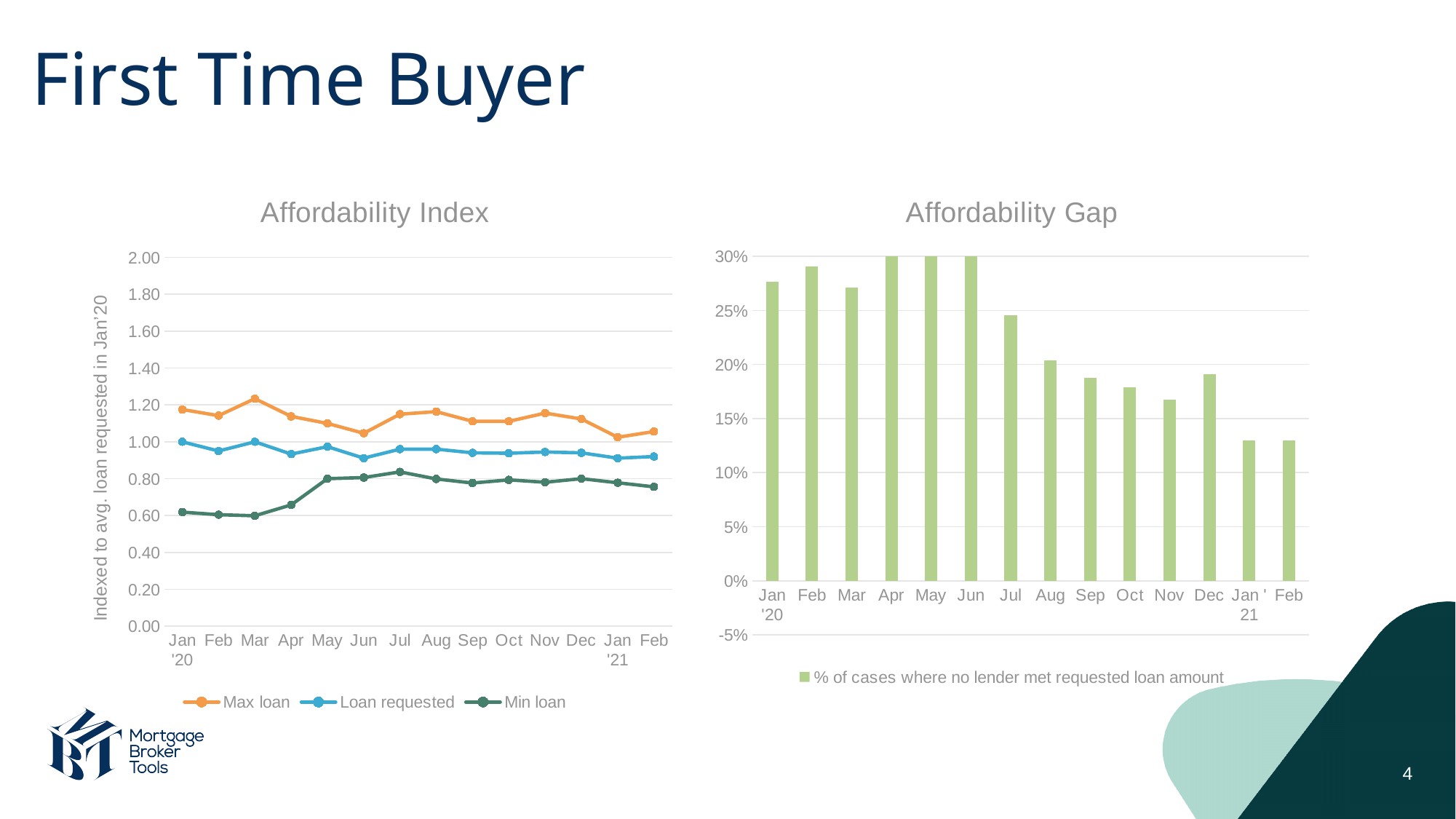
How many bars are plotted in the Affordability Gap chart? 14 In the Affordability Index chart, in which month is the Max loan series highest? Mar '20 In the Affordability Index chart, what is the value of Loan requested in Jan '20? 1.00 How many series does the legend of the Affordability Index chart list? 3 In the Affordability Gap chart, is the value for Jul greater or less than 20%? greater What kind of chart is the Affordability Gap chart? bar chart What kind of chart is the Affordability Index chart? line chart In the Affordability Index chart, is the Min loan value in Jan '20 greater or less than 0.80? less In the Affordability Gap chart, do the values rise or fall from Jun to Nov? fall In the Affordability Gap chart, is the value for Feb '21 greater or less than 15%? less In the Affordability Gap chart, which is larger, the value for Nov or the value for Dec? Dec What is the legend entry shown below the Affordability Gap chart? % of cases where no lender met requested loan amount